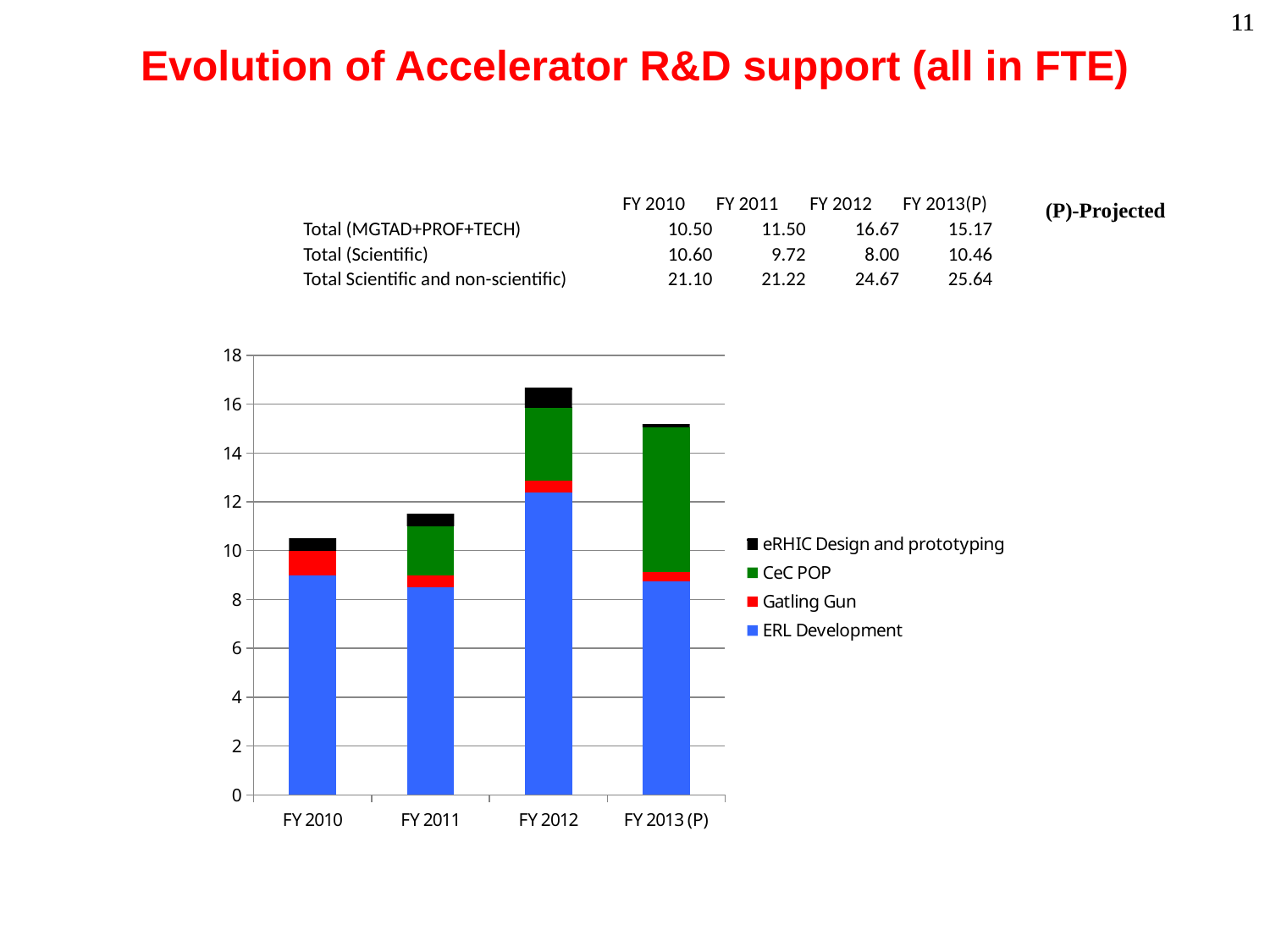
How many fiscal years are shown on the x axis of the chart? 4 What kind of chart is shown on the slide? Stacked bar chart Which is larger, the total stacked bar for FY 2012 or for FY 2013 (P)? FY 2012 Is the total stacked bar for FY 2011 greater or less than 12? less Which fiscal year has the shortest stacked bar in the chart? FY 2010 Which fiscal year has the tallest stacked bar in the chart? FY 2012 Which series is shown in green in the chart legend? CeC POP Does the total stacked bar rise or fall from FY 2011 to FY 2012? rise How many series does the chart legend list? 4 Is the ERL Development segment for FY 2012 greater or less than 10? greater Is the total stacked bar for FY 2012 greater or less than 16? greater Which is larger, the CeC POP segment for FY 2012 or for FY 2013 (P)? FY 2013 (P)